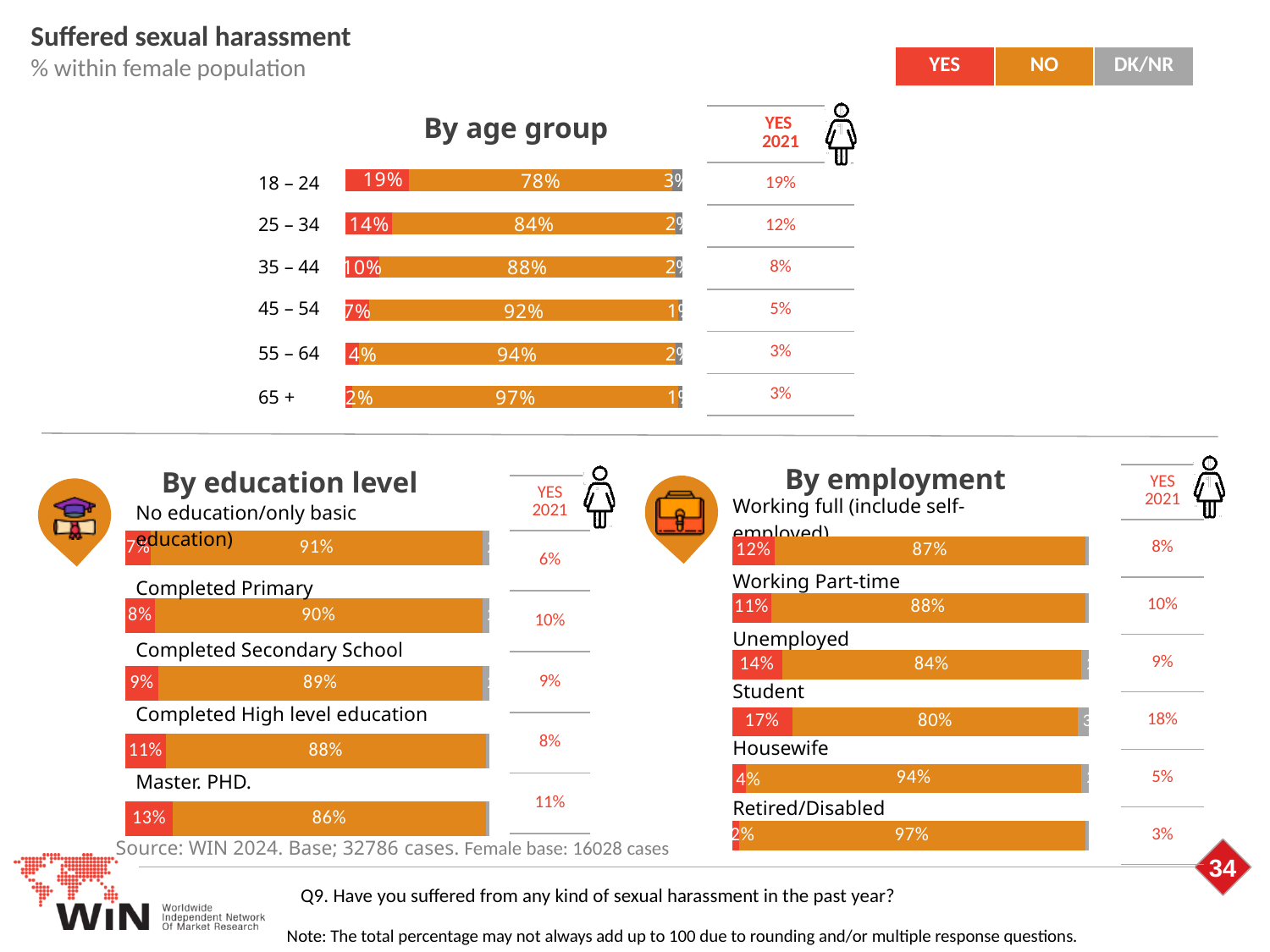
How many response categories does the legend at the top of the slide list? 3 In the 'By age group' chart, which age group has the highest YES percentage? 18 – 24 In the 'By employment' chart, what is the YES percentage for Student? 17% How many age groups are shown in the 'By age group' chart? 6 In the 'By age group' chart, what is the NO value for the 45 – 54 age group? 92% In the 'By age group' chart, which age group has the lowest YES percentage? 65 + In the 'By age group' chart, what percentage of women aged 18 – 24 answered YES? 19% In the 'By age group' chart, what is the difference between the YES values for 18 – 24 and 25 – 34? 5% In the 'By age group' chart, do the YES percentages rise or fall as age increases? fall In the 'By education level' chart, what is the YES percentage for Master. PHD.? 13% In the 'By employment' chart, which is larger, the YES value for Unemployed or for Housewife? Unemployed In the 'By education level' chart, which education level has the highest YES percentage? Master. PHD.